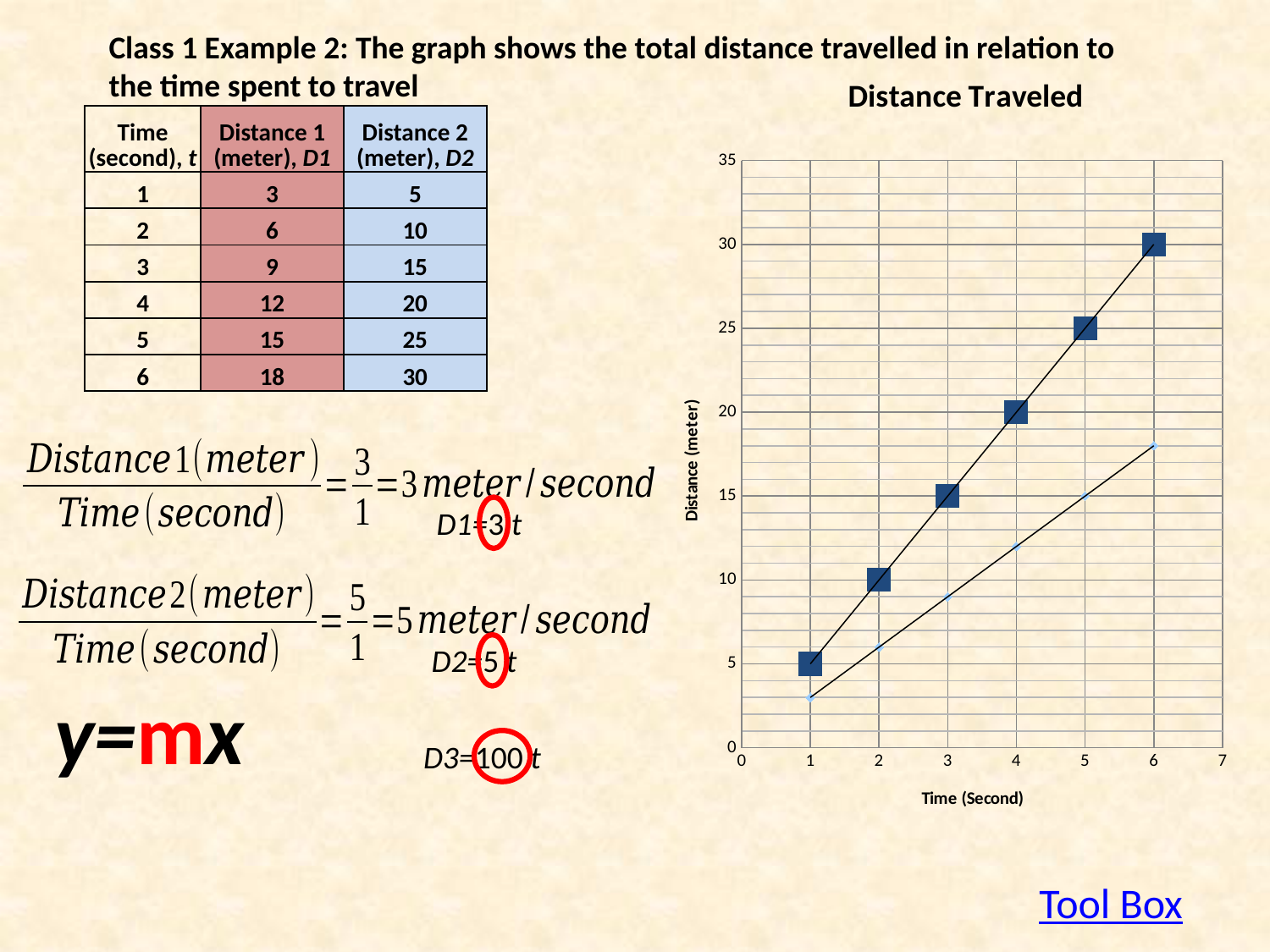
What is the label on the vertical axis of the chart? Distance (meter) How many data points are plotted on the line with large square markers? 6 On the chart, what is the distance value of the line with large square markers at time 6? 30 Do the distance values on the chart rise or fall as time increases? rise What is the title of the chart? Distance Traveled On the chart, is the value of the lower line (small markers) at time 3 greater or less than 10? less What kind of chart is shown on the slide? line chart On the chart, what is the distance value of the lower line (small markers) at time 5? 15 On the chart, what is the difference between the value of the line with large square markers at time 6 and at time 1? 25 On the chart, at time 4, which line has the higher distance value: the line with large square markers or the line with small markers? the line with large square markers On the chart, is the value of the lower line (small markers) at time 6 greater or less than 20? less On the chart, what is the distance value of the line with large square markers at time 2? 10